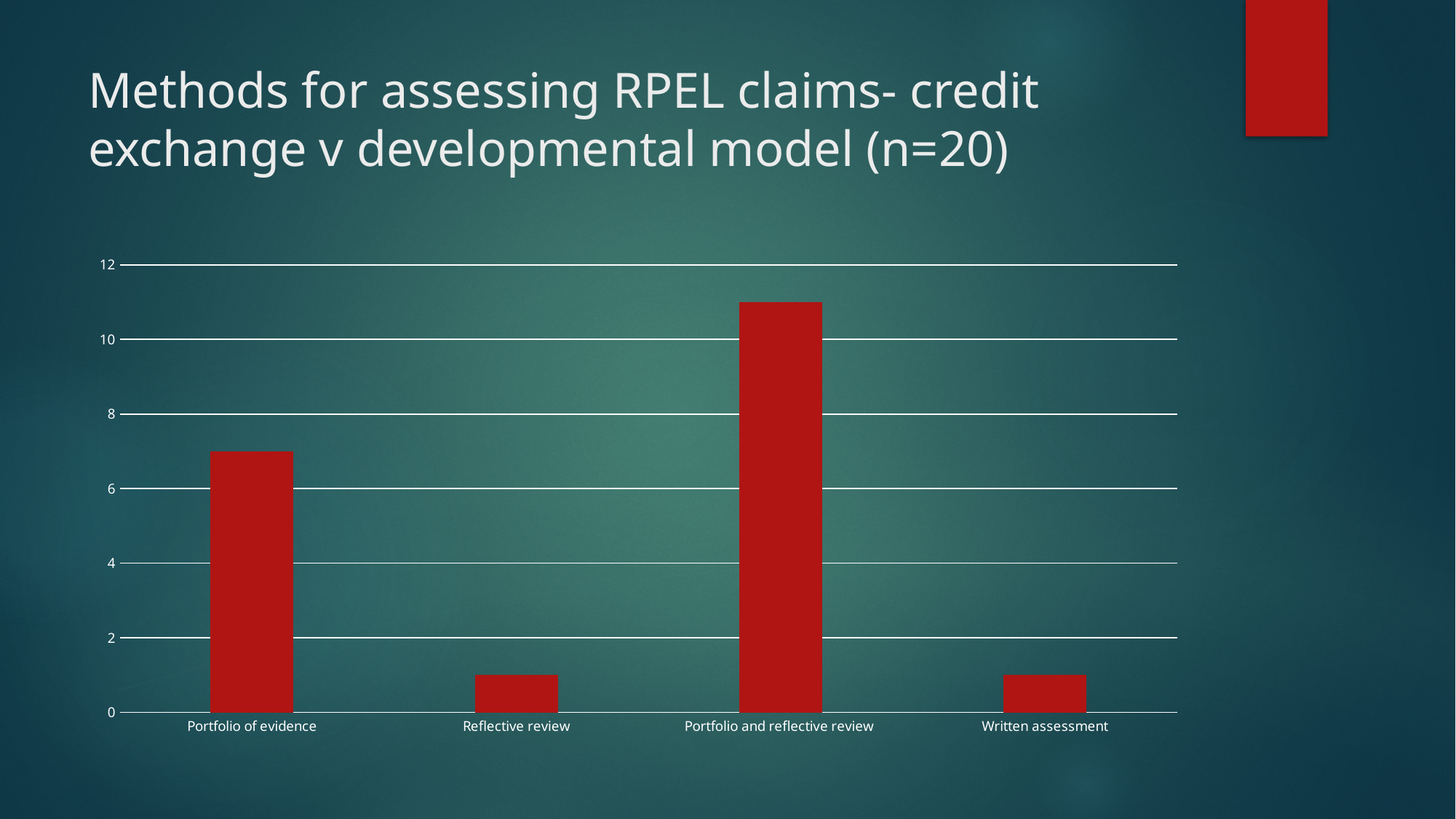
How many categories are shown on the x axis of the chart? 4 Is the value for Written assessment greater or less than 2? less What kind of chart is shown on the slide? bar chart Is the value for Portfolio and reflective review greater or less than 10? greater Which is larger, the value for Portfolio of evidence or the value for Reflective review? Portfolio of evidence Is the value for Reflective review greater or less than 2? less Which is larger, the value for Written assessment or the value for Portfolio and reflective review? Portfolio and reflective review What colour are the bars in the chart? red Which category has the highest bar in the chart? Portfolio and reflective review What is the highest value shown on the chart's vertical axis? 12